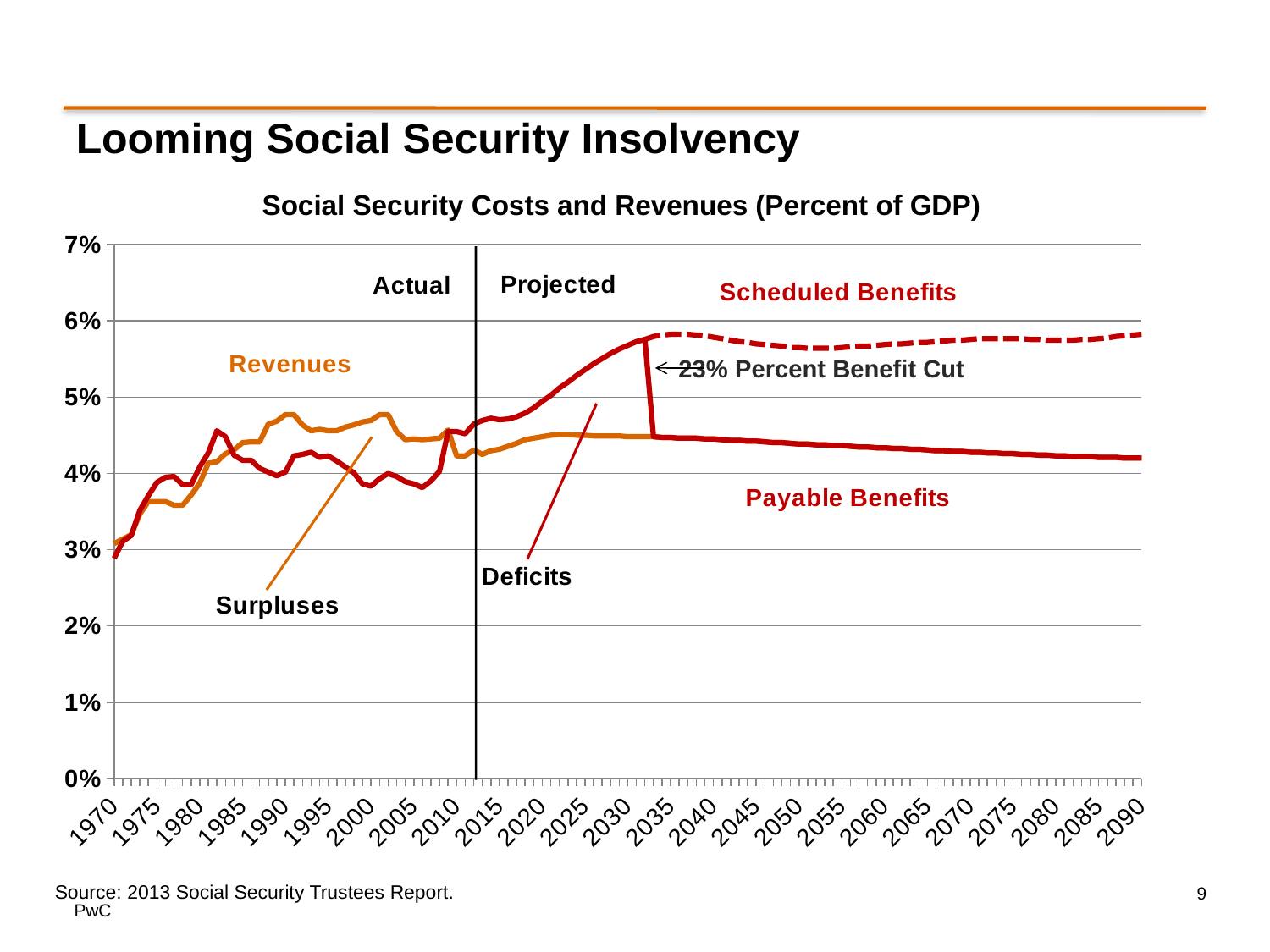
What is the title of the chart? Social Security Costs and Revenues (Percent of GDP) Is the value for Payable Benefits in 2090 greater or less than 5%? less Is the value for Scheduled Benefits in 2090 greater or less than 5%? greater Is the value for Revenues in 1970 greater or less than 4%? less In 2090, which is larger: Scheduled Benefits or Payable Benefits? Scheduled Benefits What percent benefit cut is annotated on the chart around 2033? 23% Do Scheduled Benefits rise or fall from 2015 to 2033? rise Do Payable Benefits rise or fall from 2035 to 2090? fall What kind of chart is shown on the slide? Line chart In 2030, which is larger: Scheduled Benefits or Revenues? Scheduled Benefits